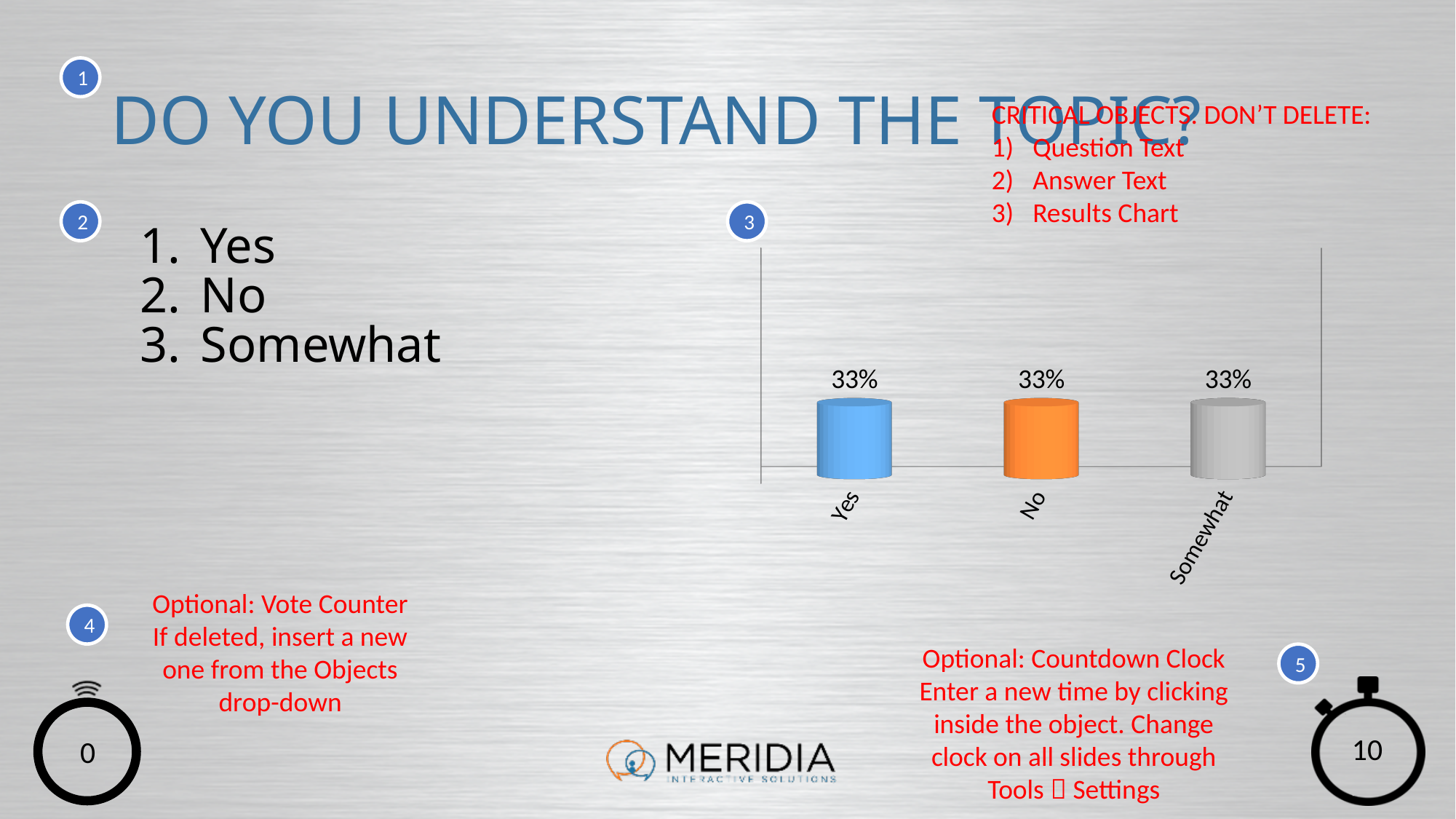
What is the value for Yes in the chart? 33% Is the value for Somewhat the same as the value for Yes? yes How many categories are shown on the chart's x axis? 3 What colour is the bar for No? orange What are the category labels on the chart's x axis, from left to right? Yes, No, Somewhat Do the values rise, fall, or stay the same across the categories from Yes to Somewhat? stay the same What is the value for No in the chart? 33% What is the value for Somewhat in the chart? 33% What is the difference between the values for Yes and No? 0% What kind of chart is shown on the slide? bar chart